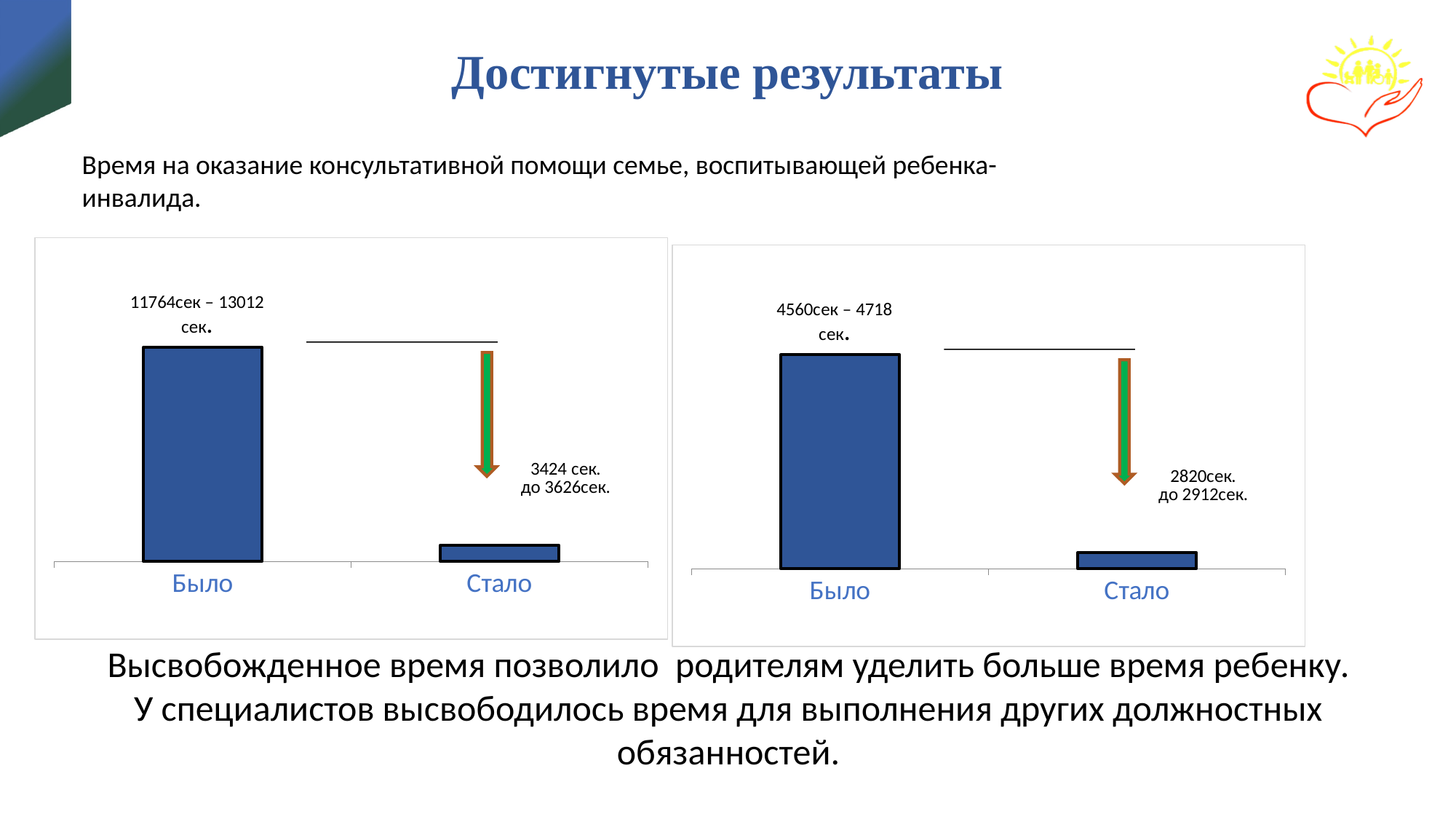
On the right chart, what label is shown for the "Стало" bar? 2820сек. до 2912сек. On the left chart, what label is shown for the "Стало" bar? 3424 сек. до 3626сек. On the left chart, what label is shown for the "Было" bar? 11764сек – 13012 сек. On the right chart, do the values rise or fall from "Было" to "Стало"? fall On the left chart, which category has the taller bar? Было What type of chart is the right chart? bar chart What is the title of the slide containing the two charts? Достигнутые результаты How many categories are shown on the left chart? 2 On the right chart, which category has the shorter bar? Стало On the right chart, is the bar for "Стало" larger or smaller than the bar for "Было"? smaller On the left chart, is the bar for "Было" larger or smaller than the bar for "Стало"? larger On the right chart, what label is shown for the "Было" bar? 4560сек – 4718 сек.